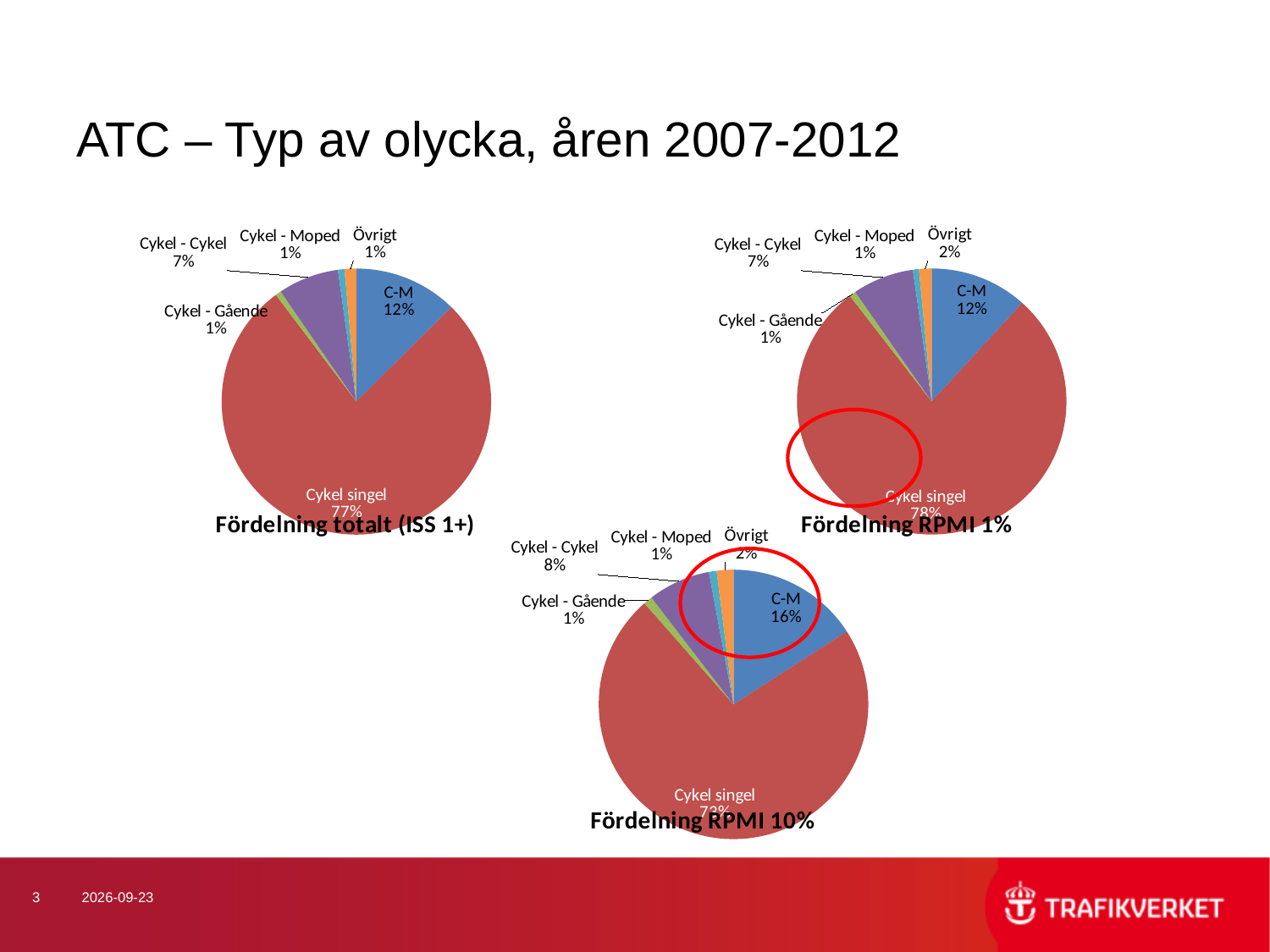
In the "Fördelning RPMI 10%" chart, what is the value for C-M? 16% In the "Fördelning RPMI 1%" chart, what share does Cykel singel have? 78% How many categories are shown in the "Fördelning RPMI 10%" chart? 6 In the "Fördelning RPMI 10%" chart, what is the value for Cykel - Cykel? 8% What kind of chart is "Fördelning totalt (ISS 1+)"? Pie chart How many pie charts are on the slide? 3 In the "Fördelning RPMI 1%" chart, what is the value for Övrigt? 2% In the "Fördelning totalt (ISS 1+)" chart, what is the value for C-M? 12% In the "Fördelning RPMI 1%" chart, what is the difference between C-M and Cykel - Cykel? 5% In the "Fördelning totalt (ISS 1+)" chart, which category has the largest share? Cykel singel Which is larger: C-M in the "Fördelning RPMI 10%" chart or C-M in the "Fördelning totalt (ISS 1+)" chart? Fördelning RPMI 10% In the "Fördelning totalt (ISS 1+)" chart, what share does Cykel singel have? 77%